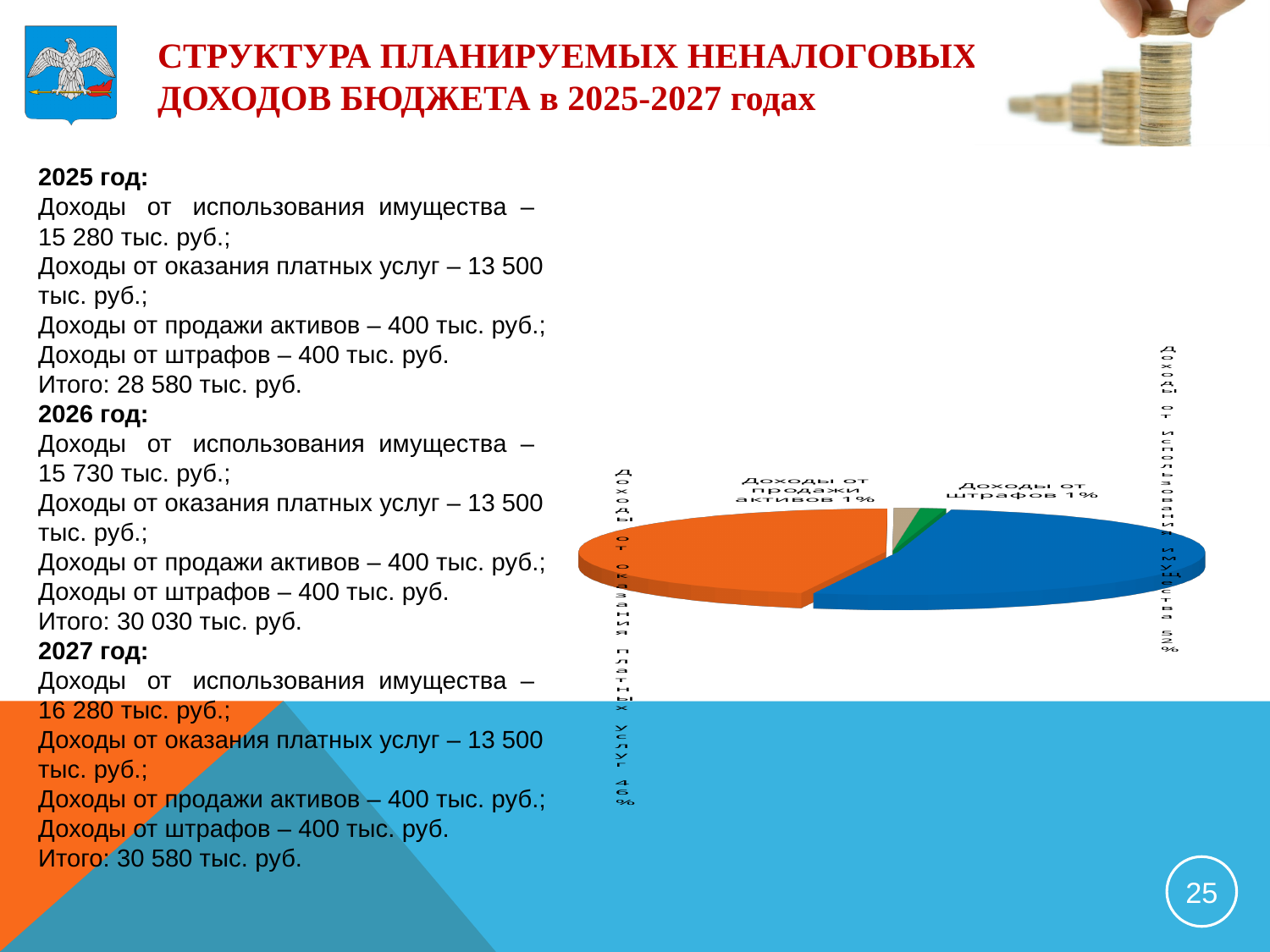
What kind of chart is shown on the slide? Pie chart Which category has the largest slice in the pie chart? Доходы от использования имущества What share of the pie chart is labelled for Доходы от штрафов? 1% What colour is the slice for Доходы от использования имущества? Blue What share of the pie chart is labelled for Доходы от продажи активов? 1% What share of the pie chart is labelled for Доходы от оказания платных услуг? 46% What colour is the slice for Доходы от оказания платных услуг? Orange By how many percentage points does the share of Доходы от использования имущества exceed the share of Доходы от оказания платных услуг? 6 Which slice is larger: Доходы от оказания платных услуг or Доходы от продажи активов? Доходы от оказания платных услуг How many slices does the pie chart have? 4 Which slice is larger: Доходы от использования имущества or Доходы от оказания платных услуг? Доходы от использования имущества